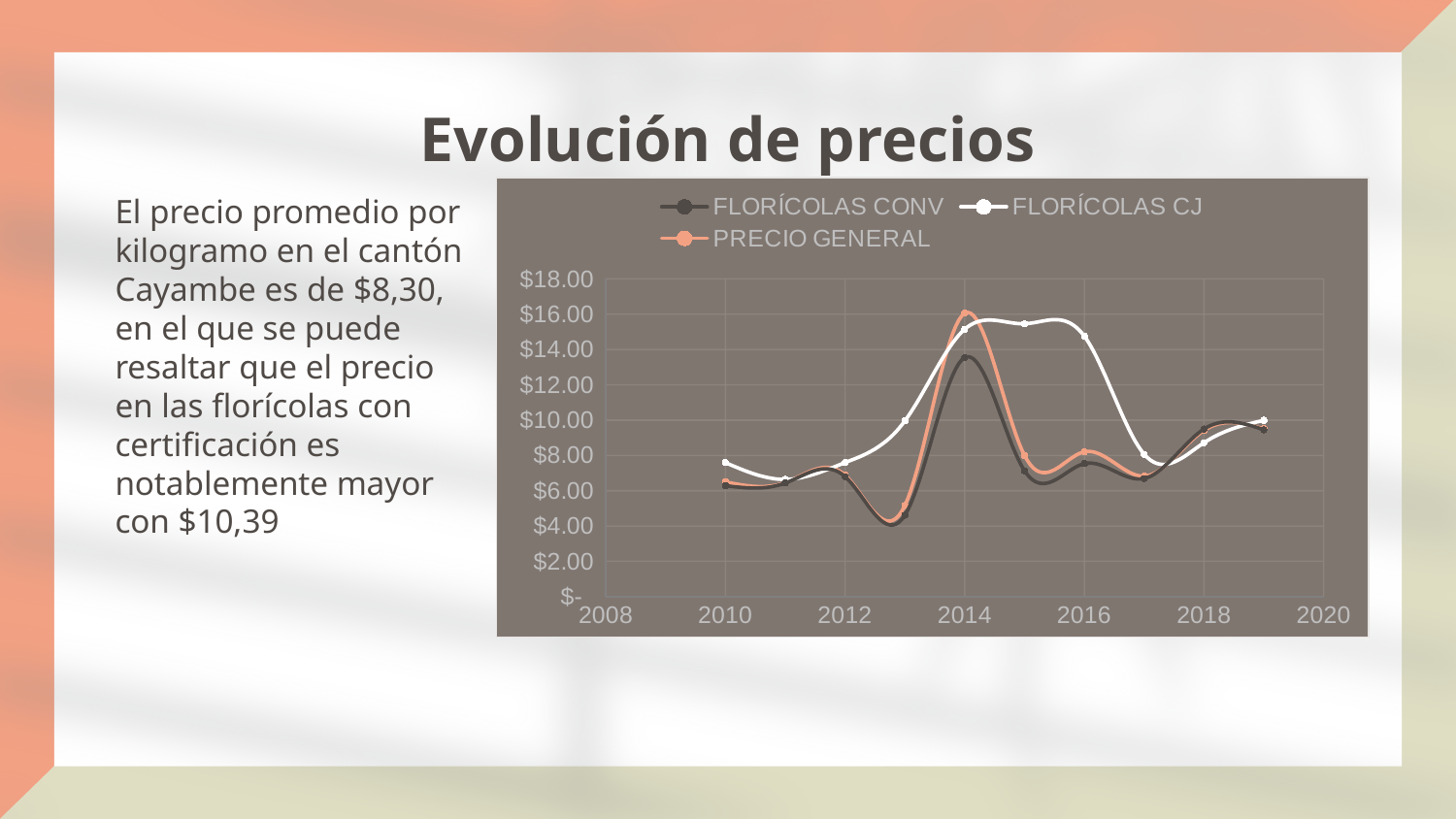
In 2016, which is larger: FLORÍCOLAS CJ or FLORÍCOLAS CONV? FLORÍCOLAS CJ How many series does the chart legend list? 3 Is the value for FLORÍCOLAS CONV in 2013 greater or less than $6.00? less What is the title of the slide containing the chart? Evolución de precios In 2014, which is larger: PRECIO GENERAL or FLORÍCOLAS CONV? PRECIO GENERAL How many data points does the FLORÍCOLAS CONV series have? 10 What kind of chart is shown on the slide? line chart Is the value for PRECIO GENERAL in 2014 greater or less than $14.00? greater Which series is drawn in white on the chart? FLORÍCOLAS CJ Is the value for FLORÍCOLAS CJ in 2016 greater or less than $14.00? greater Does the FLORÍCOLAS CJ series rise or fall from 2016 to 2017? fall In which year does the FLORÍCOLAS CONV series reach its highest value? 2014